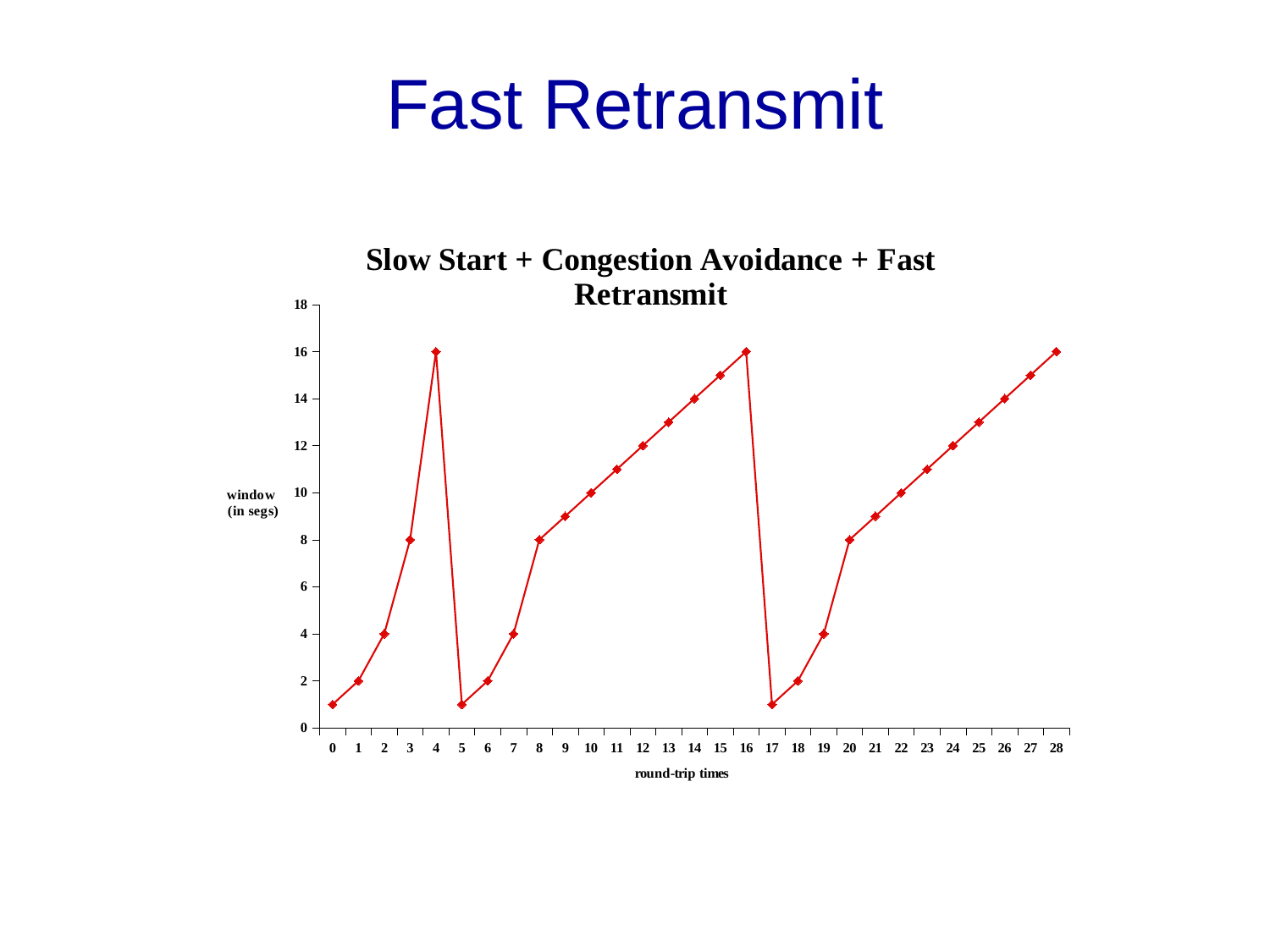
What type of chart is shown on the slide? line chart Which has the larger window size: round-trip time 4 or round-trip time 5? round-trip time 4 Is the window size at round-trip time 13 greater or less than 12? greater What is the difference between the window size at round-trip time 4 and at round-trip time 3? 8 What is the window size (in segs) at round-trip time 3? 8 Is the window size at round-trip time 17 greater or less than 2? less What is the window size (in segs) at round-trip time 20? 8 Between round-trip times 5 and 16, does the window size rise or fall? rise What is the window size (in segs) at round-trip time 12? 12 What is the label of the x axis of the chart? round-trip times What is the window size (in segs) at round-trip time 4? 16 How many round-trip time points are plotted on the chart? 29